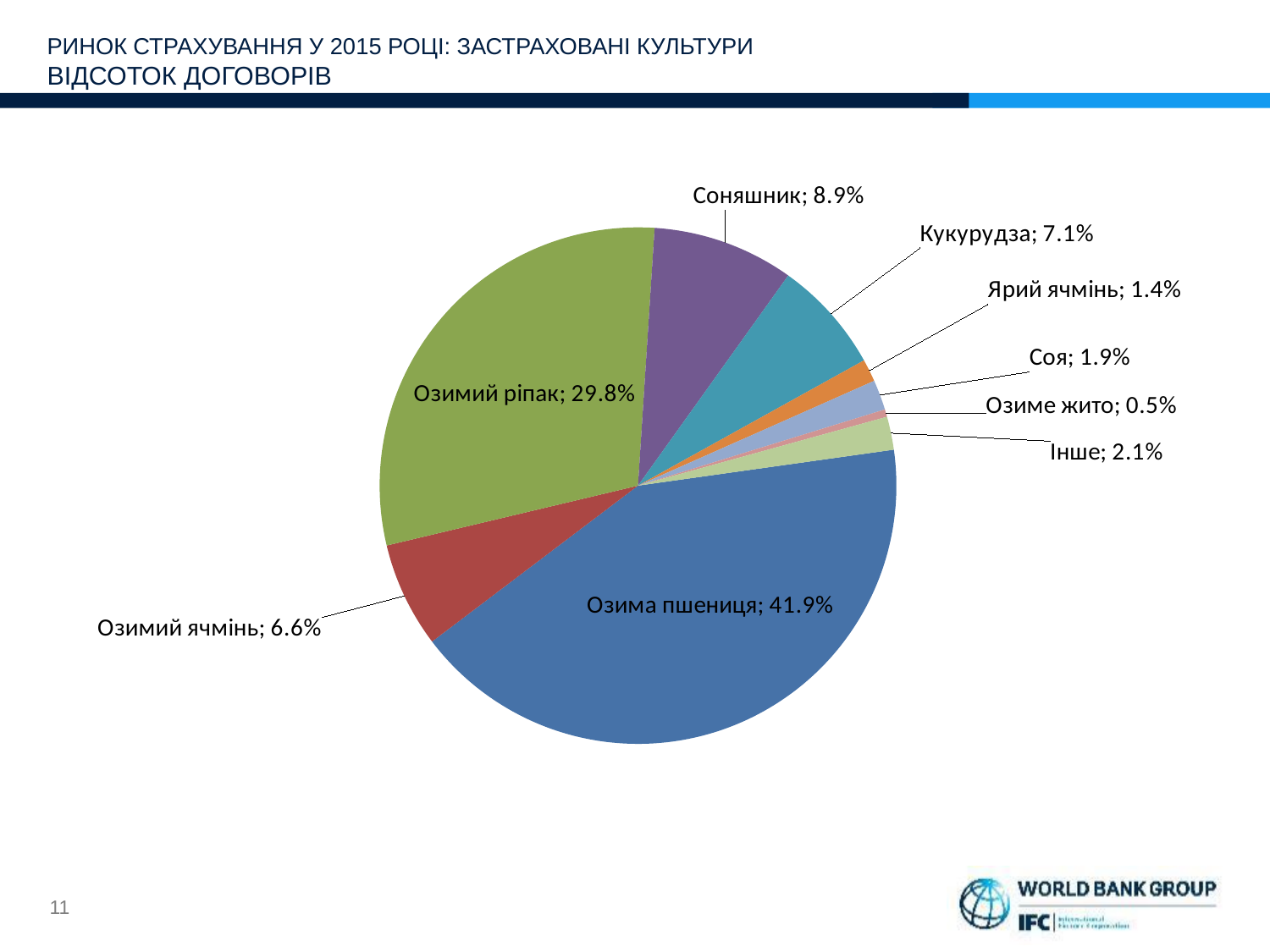
Which is larger, the share for Кукурудза or the share for Озимий ячмінь? Кукурудза What percentage is shown for Соняшник? 8.9% What is the value for Озиме жито? 0.5% What type of chart is shown on the slide? pie chart What is the value shown for Озимий ріпак? 29.8% Which crop has the largest slice of the pie? Озима пшениця What share of contracts does Озима пшениця account for? 41.9% What is the difference between the shares of Озима пшениця and Озимий ріпак? 12.1% How many slices does the pie chart have? 9 What is the combined share of Соя and Ярий ячмінь? 3.3% What is the title of the slide containing the chart? РИНОК СТРАХУВАННЯ У 2015 РОЦІ: ЗАСТРАХОВАНІ КУЛЬТУРИ ВІДСОТОК ДОГОВОРІВ Which crop has the smallest slice of the pie? Озиме жито